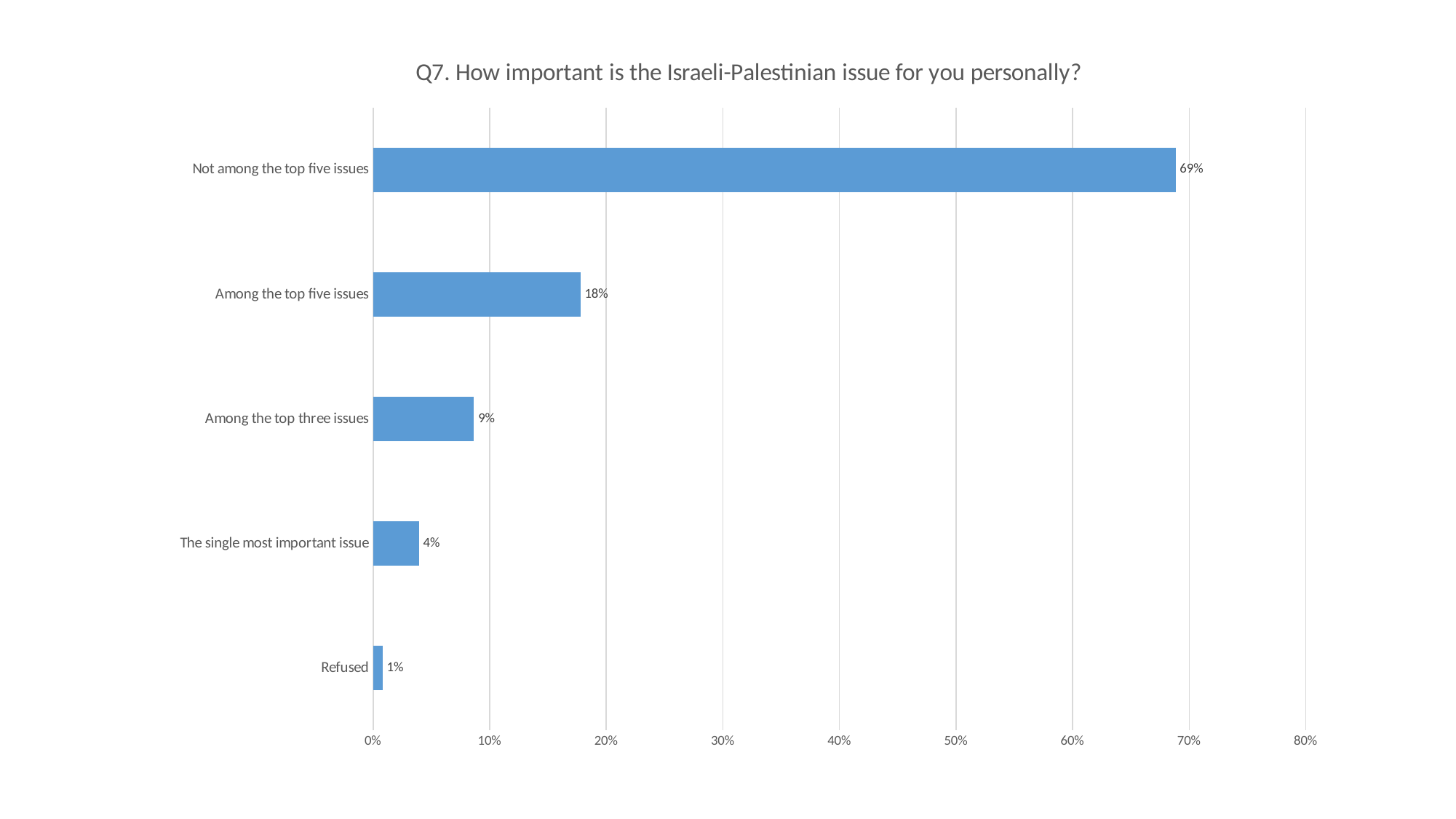
What is the value for 'The single most important issue'? 4% What is the title of the chart? Q7. How important is the Israeli-Palestinian issue for you personally? What percentage of respondents said the issue is not among the top five issues? 69% What percentage said the issue is among the top three issues? 9% How many categories are shown in the chart? 5 What is the difference between 'Not among the top five issues' and 'Among the top five issues'? 51% Which category has the highest value? Not among the top five issues Which is larger: 'Among the top three issues' or 'The single most important issue'? Among the top three issues What type of chart is shown on the slide? Bar chart Which category has the lowest value? Refused What percentage of respondents refused to answer? 1% What is the value for 'Among the top five issues'? 18%